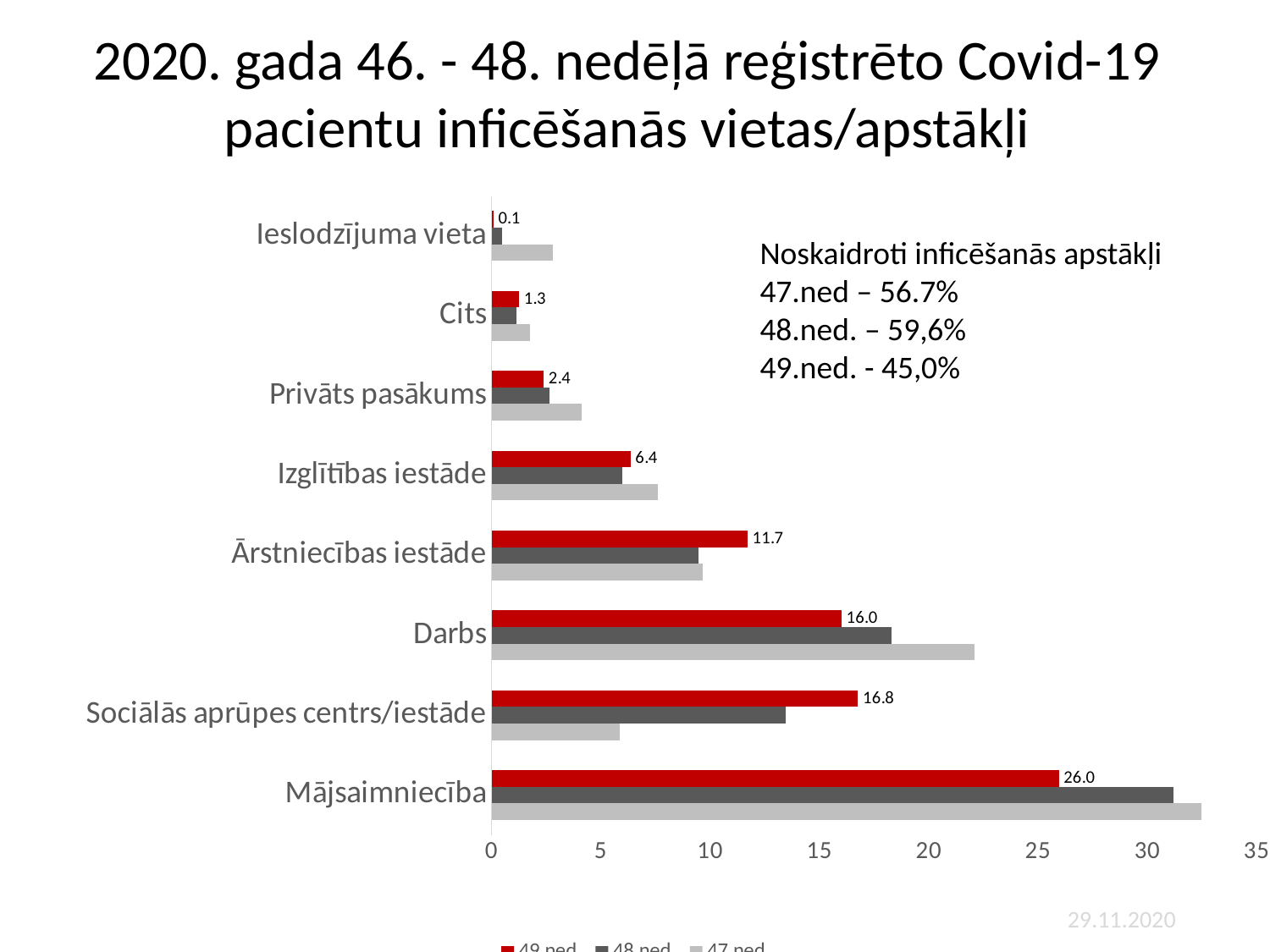
In the 49.ned series, which is larger: Sociālās aprūpes centrs/iestāde or Darbs? Sociālās aprūpes centrs/iestāde How many series does the legend list? 3 Which category has the highest value in the 49.ned series? Mājsaimniecība What is the value for Mājsaimniecība in the 49.ned series? 26.0 Is the 47.ned value for Mājsaimniecība greater or less than 30? greater What is the value for Ārstniecības iestāde in the 49.ned series? 11.7 Which colour represents the 49.ned series? red What kind of chart is shown on the slide? bar chart Which category has the lowest value in the 49.ned series? Ieslodzījuma vieta What is the value for Izglītības iestāde in the 49.ned series? 6.4 What is the difference between the 49.ned values for Mājsaimniecība and Darbs? 10.0 How many categories are shown on the chart? 8